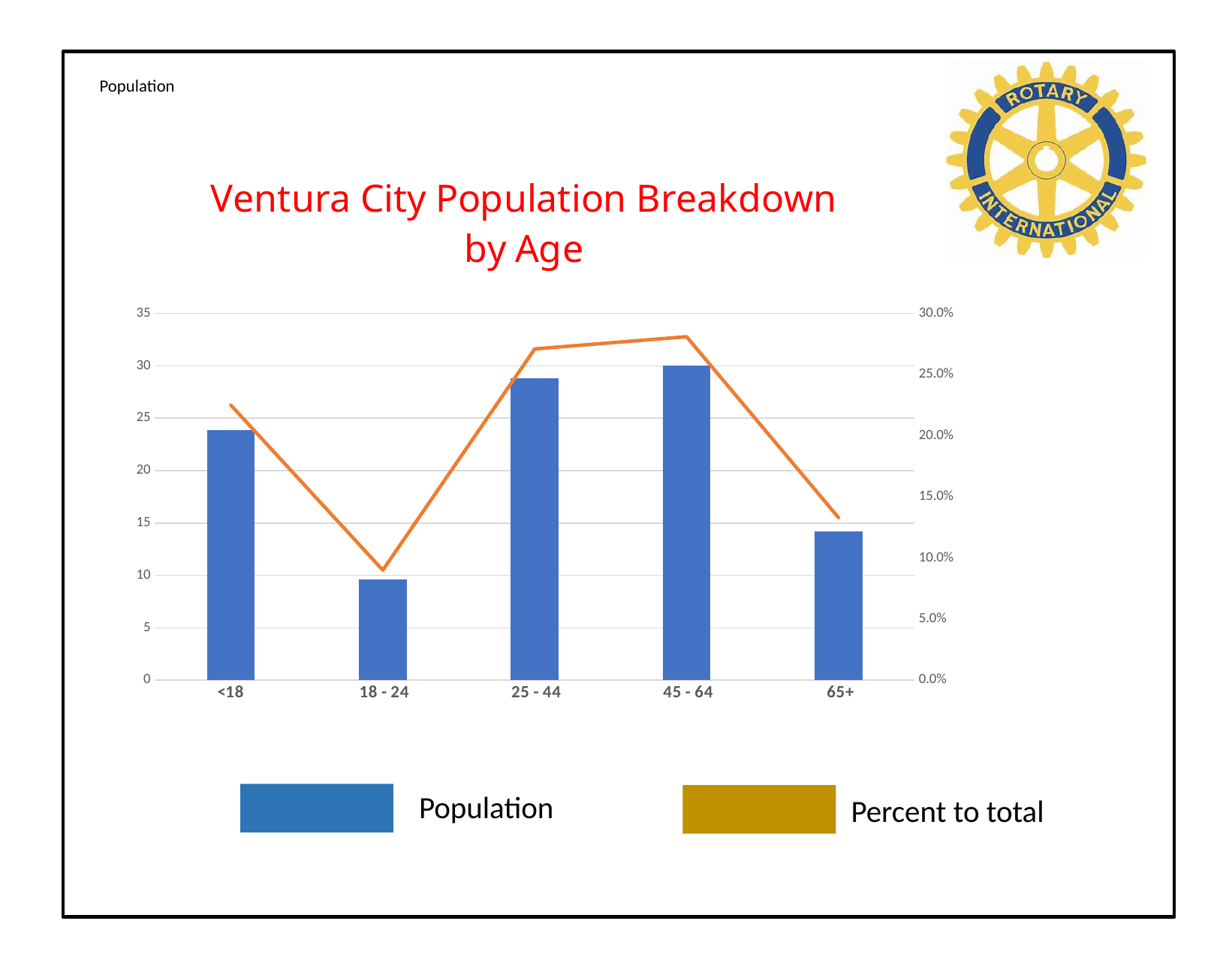
Is the Percent to total value for <18 greater or less than 20.0%? greater How many series does the legend list? 2 Is the Population value for 65+ greater or less than 15? less What is the title of the chart? Ventura City Population Breakdown by Age How many age categories are shown on the x axis? 5 Is the Population value for <18 greater or less than 20? greater What kind of chart is shown on the slide? A bar chart combined with a line Which has the larger Population bar, <18 or 65+? <18 Which age group has the highest Population bar? 45 - 64 Which age group has the lowest Population bar? 18 - 24